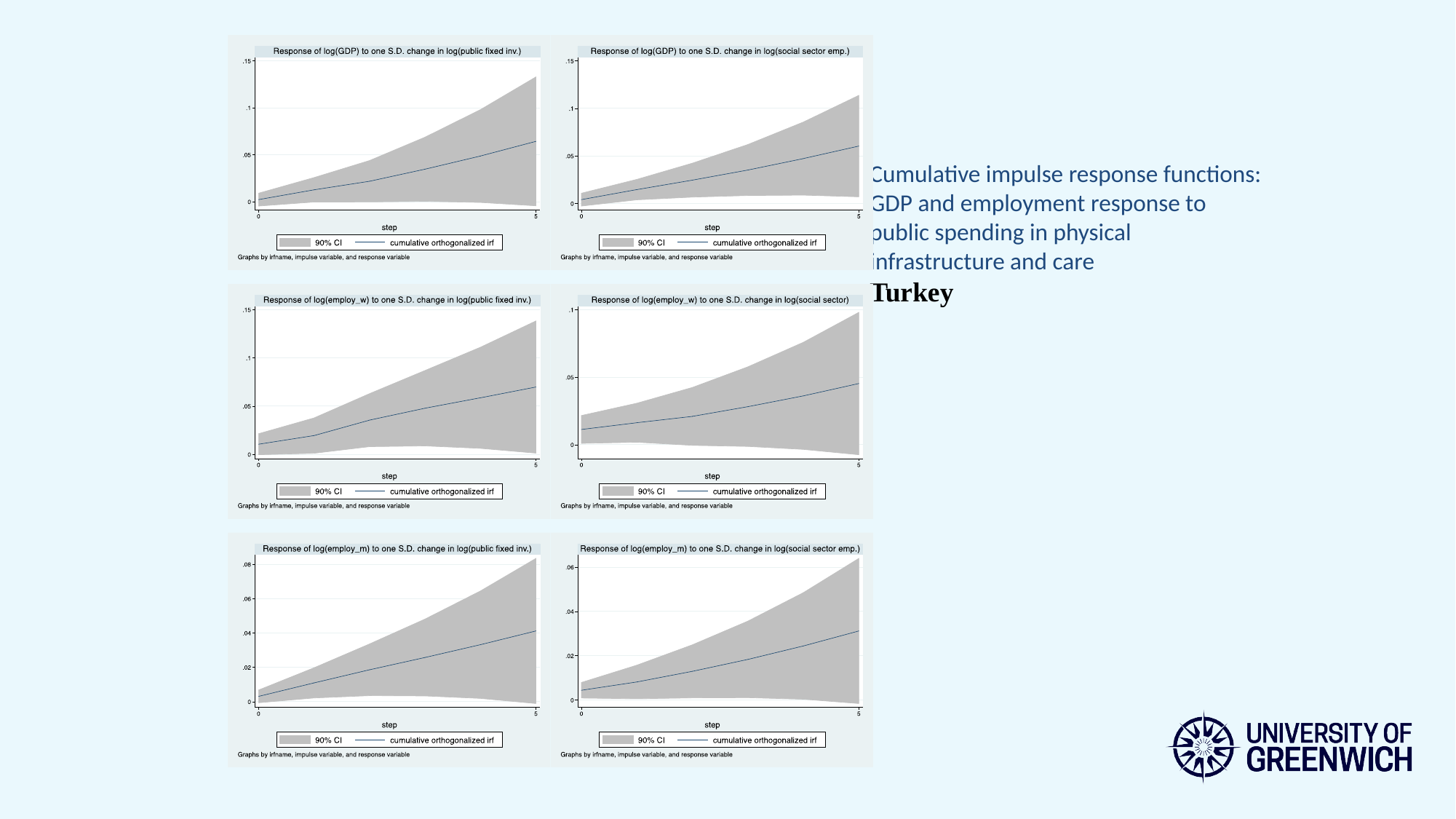
In the bottom-left chart, 'Response of log(employ_m) to one S.D. change in log(public fixed inv.)', is the cumulative orthogonalized irf value at step 5 greater or less than .06? less How many entries does the legend list in the top-right chart, 'Response of log(GDP) to one S.D. change in log(social sector emp.)'? 2 In the middle-right chart, 'Response of log(employ_w) to one S.D. change in log(social sector)', does the cumulative orthogonalized irf line rise or fall along the x axis? rise What does the shaded grey area represent according to the legend in the top-left chart, 'Response of log(GDP) to one S.D. change in log(public fixed inv.)'? 90% CI In the top-left chart, 'Response of log(GDP) to one S.D. change in log(public fixed inv.)', is the cumulative orthogonalized irf value at step 5 greater or less than .05? greater In the bottom-right chart, 'Response of log(employ_m) to one S.D. change in log(social sector emp.)', is the cumulative orthogonalized irf value at step 5 greater or less than .04? less In the top-left chart, 'Response of log(GDP) to one S.D. change in log(public fixed inv.)', does the cumulative orthogonalized irf line rise or fall as step increases? rise What is the x-axis label on the bottom-left chart, 'Response of log(employ_m) to one S.D. change in log(public fixed inv.)'? step What kind of chart is the top-left chart, 'Response of log(GDP) to one S.D. change in log(public fixed inv.)'? line chart How many charts are shown on the slide? 6